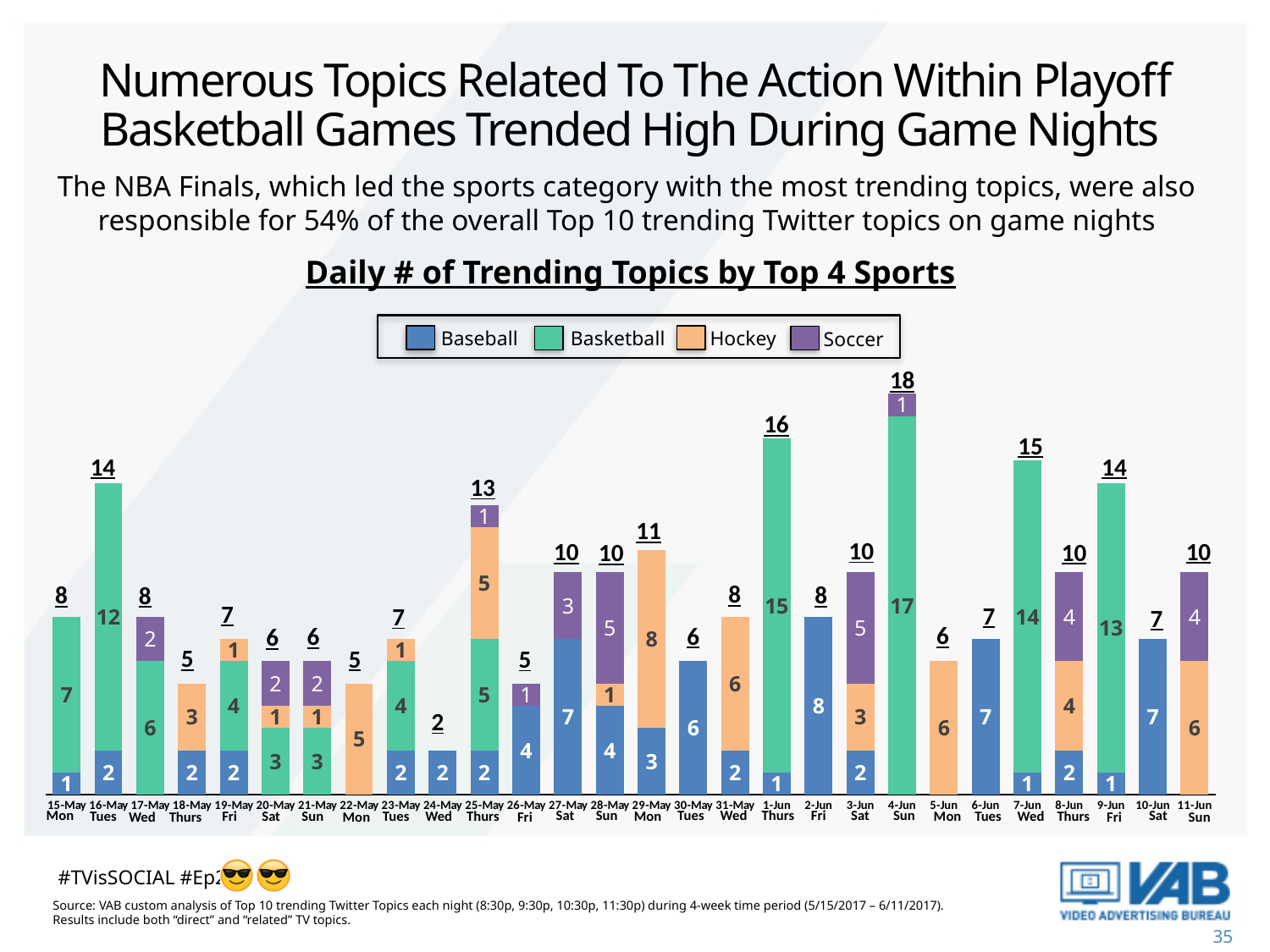
How many Basketball trending topics were there on 4-Jun Sun? 17 What is the total number of trending topics on 1-Jun Thurs? 16 How many days are shown on the x axis of the chart? 28 What is the difference between the total trending topics on 4-Jun Sun and 7-Jun Wed? 3 Which day had more total trending topics, 16-May Tues or 25-May Thurs? 16-May Tues Which colour represents Hockey in the legend? Orange How many Hockey trending topics were there on 29-May Mon? 8 Which day has the highest total number of trending topics? 4-Jun Sun How many Soccer trending topics were there on 28-May Sun? 5 What type of chart is shown on the slide? Stacked bar chart Which day has the lowest total number of trending topics? 24-May Wed How many series does the legend list in the 'Daily # of Trending Topics by Top 4 Sports' chart? 4